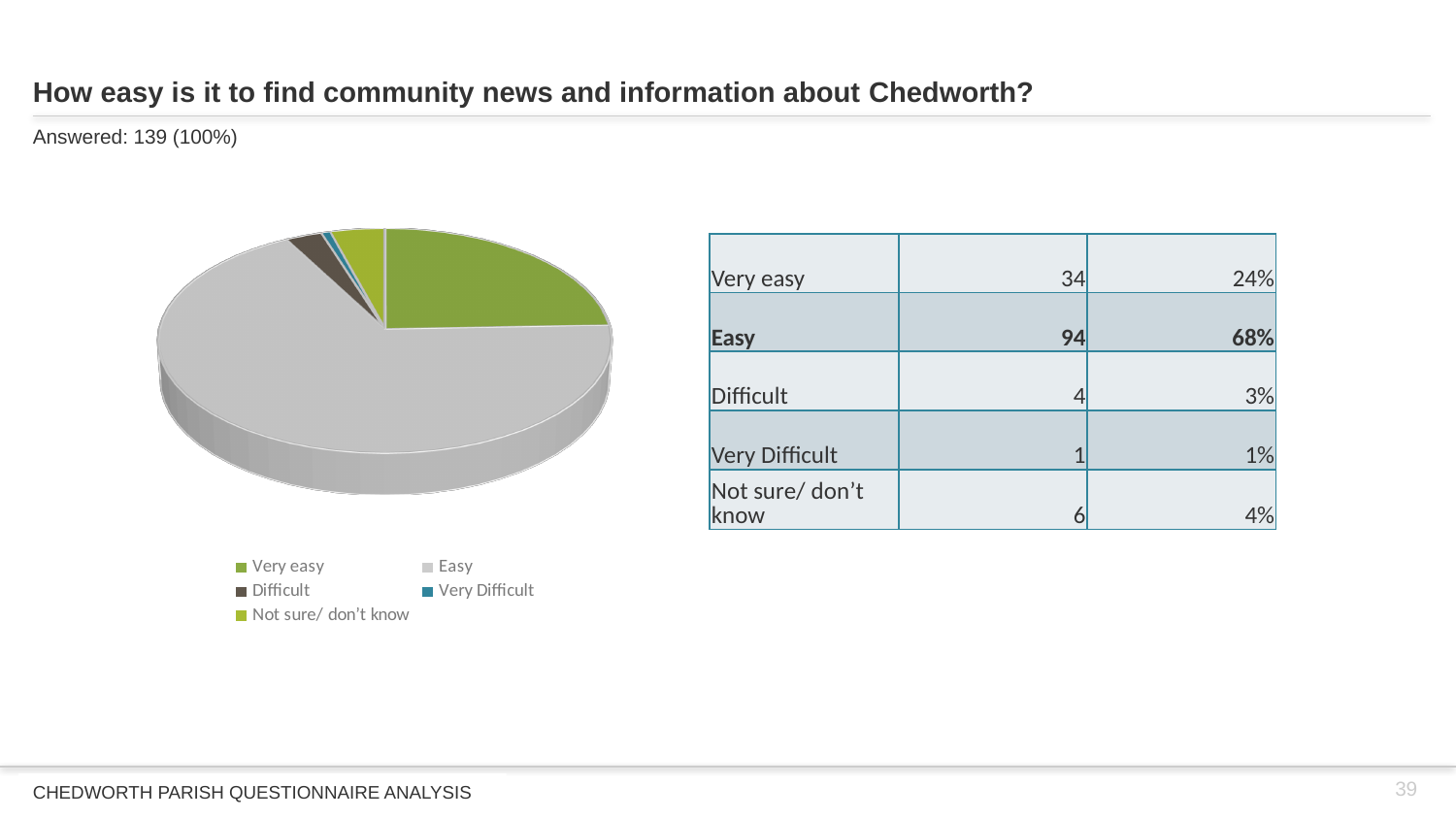
How many categories does the pie chart's legend list? 5 How many respondents answered "Easy"? 94 What kind of chart is shown on the slide? pie chart How many respondents answered "Not sure/ don't know"? 6 What share of the pie does "Very Difficult" represent? 1% Which has more respondents, "Difficult" or "Not sure/ don't know"? Not sure/ don't know What colour is the "Easy" slice in the pie chart? grey Which category has the largest share of the pie? Easy What percentage of respondents answered "Difficult"? 3% What is the difference in the number of respondents between "Easy" and "Very easy"? 60 Which category has the smallest share of the pie? Very Difficult What percentage of respondents answered "Very easy"? 24%